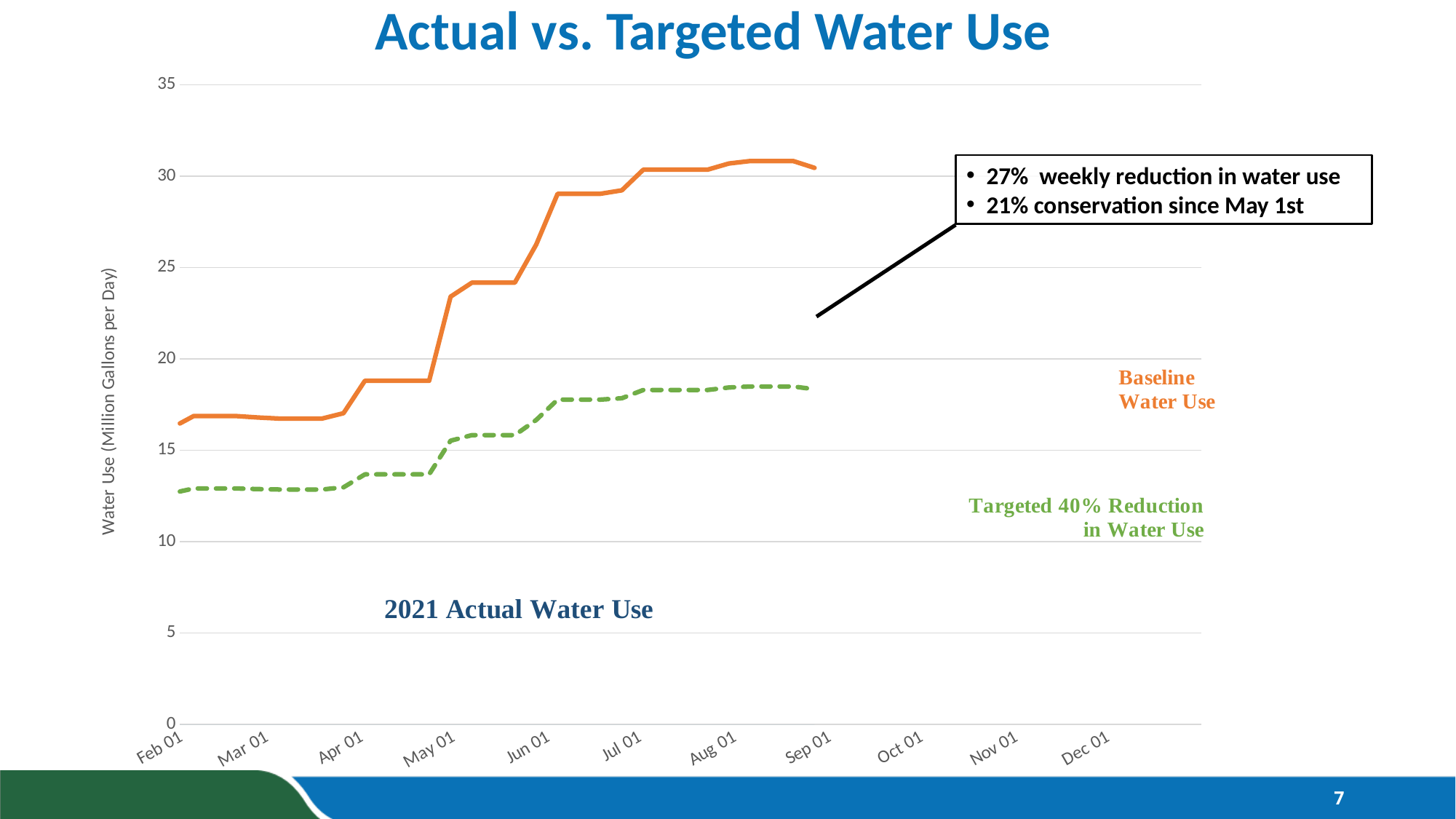
What is the label on the vertical axis? Water Use (Million Gallons per Day) Is the Baseline Water Use value at Jun 01 greater or less than 20? greater At Jul 01, which line is higher: Baseline Water Use or Targeted 40% Reduction in Water Use? Baseline Water Use Is the Targeted 40% Reduction in Water Use value at Feb 01 greater or less than 15? less How many month labels are shown on the horizontal axis? 11 What is the title of the chart? Actual vs. Targeted Water Use Is the Baseline Water Use value at Feb 01 greater or less than 20? less Does the Targeted 40% Reduction in Water Use line rise or fall from Feb 01 to Sep 01? rise Does the Baseline Water Use line rise or fall from Feb 01 to Sep 01? rise What kind of chart is shown on the slide? line chart